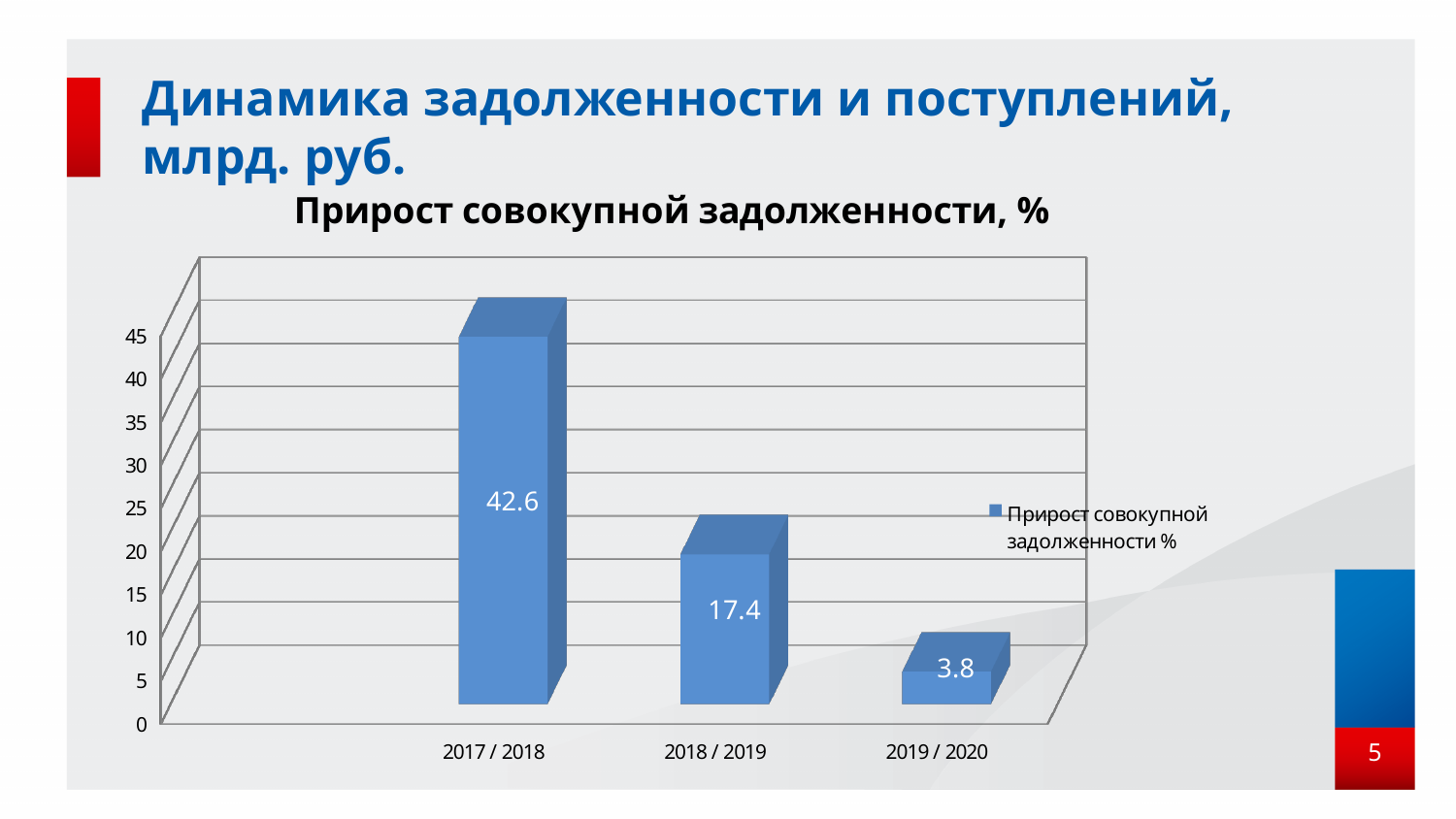
What is the value for 2019 / 2020? 3.8 What is the value for 2017 / 2018? 42.6 Which period has the highest value? 2017 / 2018 Which period has the lowest value? 2019 / 2020 How many series does the legend list? 1 How many periods are shown on the x axis? 3 What is the value for 2018 / 2019? 17.4 Do the values rise or fall from 2017 / 2018 to 2019 / 2020? fall What is the difference between the values for 2018 / 2019 and 2019 / 2020? 13.6 What kind of chart is shown? bar chart Which is larger, the value for 2018 / 2019 or the value for 2019 / 2020? 2018 / 2019 What is the difference between the values for 2017 / 2018 and 2018 / 2019? 25.2